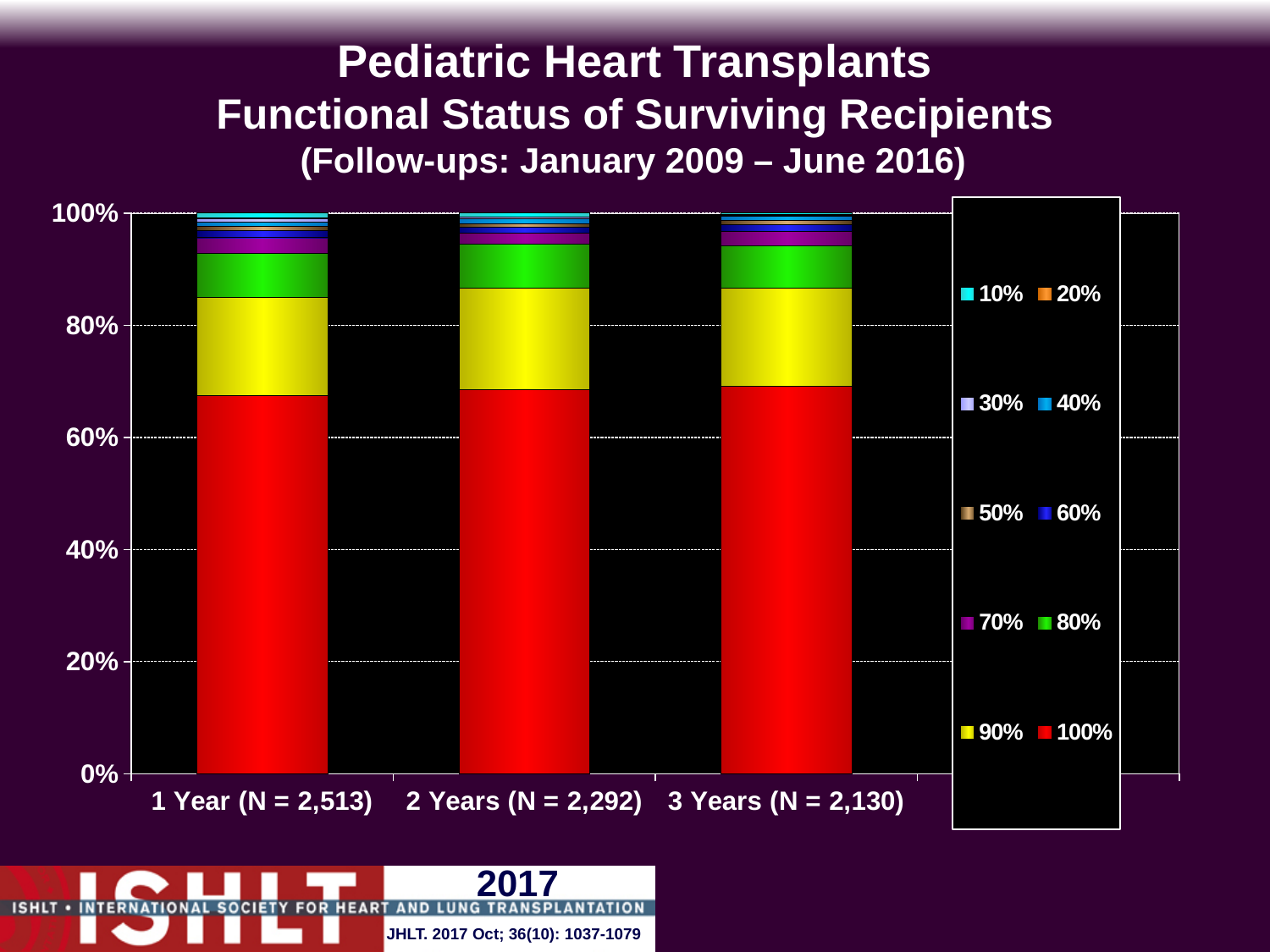
How many categories are shown on the x axis? 3 Is the value of the 100% series for 1 Year greater or less than 60%? greater What is the N for the 2 Years category? 2,292 What colour represents the 100% series in the legend? red Is the value of the 90% series for 2 Years greater or less than 40%? less What is the N for the 1 Year category? 2,513 What is the N for the 3 Years category? 2,130 What kind of chart is shown on the slide? stacked bar chart What follow-up period does the chart title give? January 2009 – June 2016 How many series does the legend list? 10 What is the total height of the stacked bar for 1 Year? 100% Is the value of the 100% series for 3 Years greater or less than 80%? less